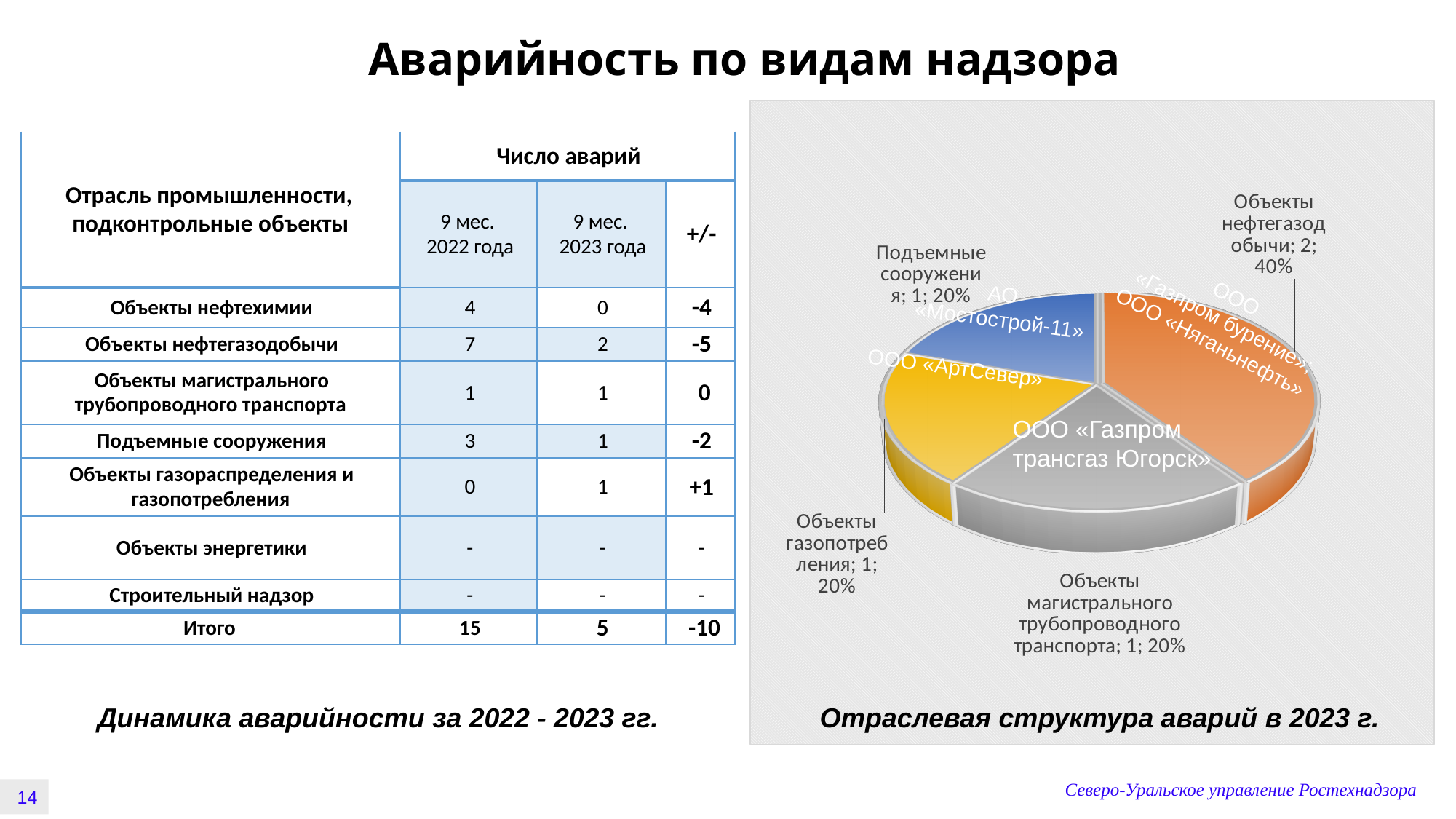
How many slices does the pie chart have? 4 In the pie chart, how many accidents are shown for Объекты газопотребления? 1 What colour is the slice for Объекты нефтегазодобычи in the pie chart? Orange In the pie chart, which is larger: the slice for Объекты нефтегазодобычи or the slice for Объекты газопотребления? Объекты нефтегазодобычи In the pie chart, what share is shown for Подъемные сооружения? 20% Which category has the largest slice in the pie chart? Объекты нефтегазодобычи In the pie chart, what share of accidents in 2023 is attributed to Объекты нефтегазодобычи? 40% In the pie chart, what is the difference in share between Объекты нефтегазодобычи and Подъемные сооружения? 20% In the pie chart, what share is shown for Объекты магистрального трубопроводного транспорта? 20% What is the title of the pie chart on the slide? Отраслевая структура аварий в 2023 г. What kind of chart is shown on the right side of the slide? Pie chart In the pie chart, how many accidents are shown for Объекты нефтегазодобычи? 2